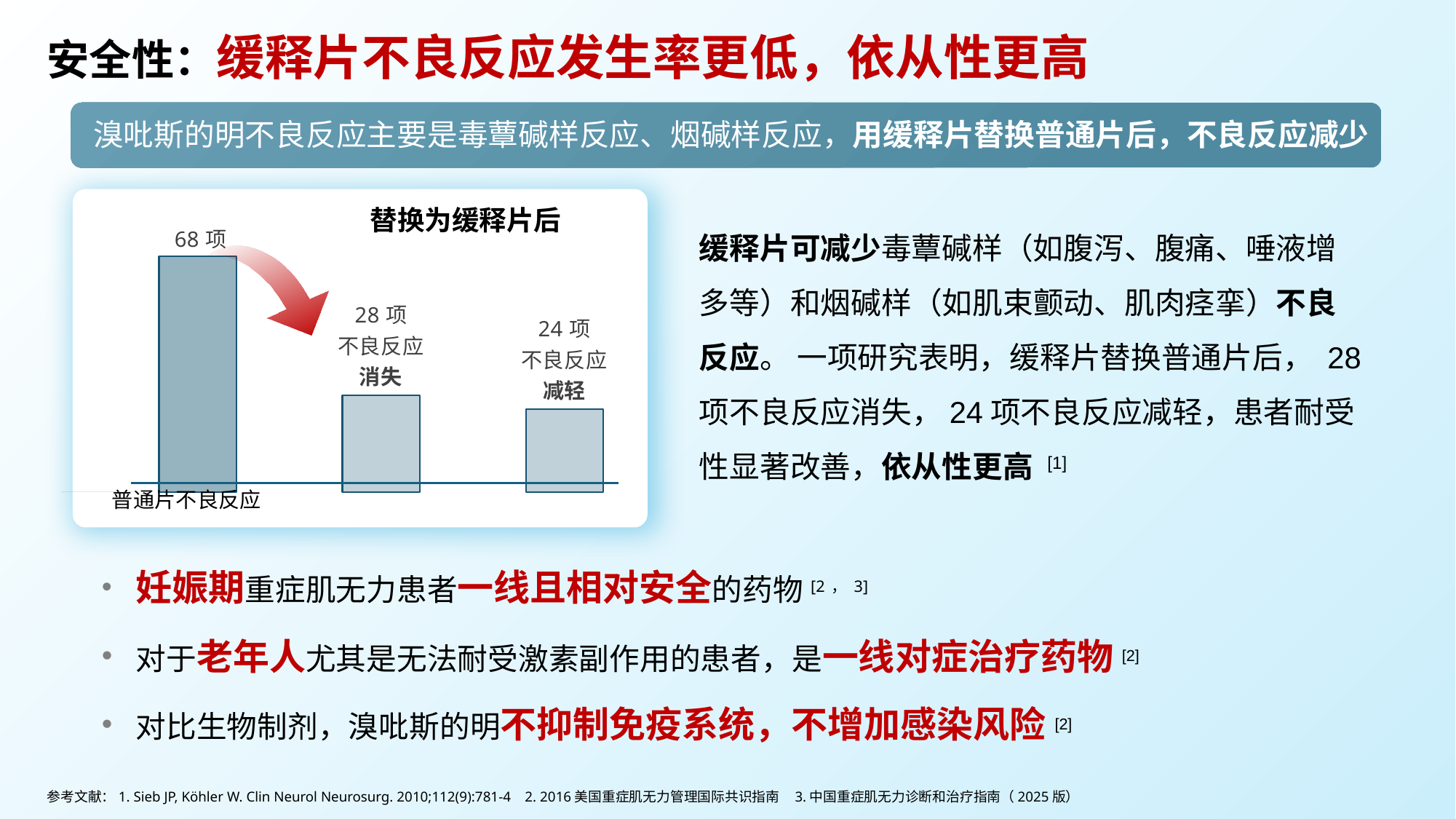
What is the difference between the 普通片不良反应 value and the 不良反应消失 value? 40 项 What is the value shown for 普通片不良反应? 68 项 What is the difference between the 不良反应消失 value and the 不良反应减轻 value? 4 项 After switching to 缓释片, how many adverse reactions are labelled 不良反应减轻? 24 项 How many bars are plotted in the chart? 3 Which bar has the highest value? 普通片不良反应 (68 项) What kind of chart is shown on the slide? bar chart Which bar has the lowest value? 不良反应减轻 (24 项) After switching to 缓释片, how many adverse reactions are labelled 不良反应消失? 28 项 What heading is shown above the two right-hand bars in the chart? 替换为缓释片后 Do the bar values rise or fall from left to right? fall Which is larger, the 不良反应消失 bar or the 不良反应减轻 bar? 不良反应消失